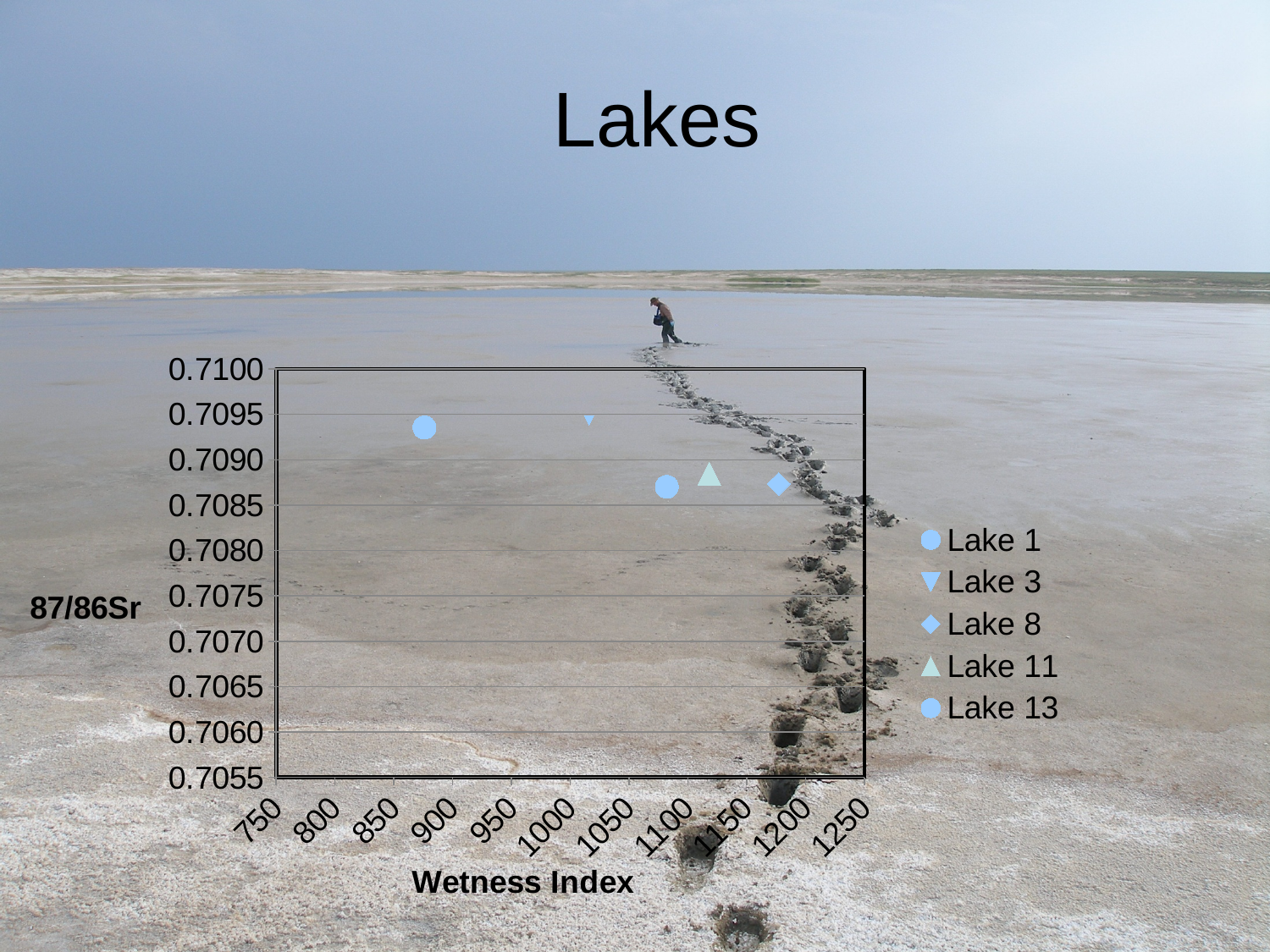
Is the 87/86Sr value for Lake 3 greater or less than 0.7090? greater How many series does the legend list? 5 Which lake has the highest Wetness Index? Lake 8 Which has the higher 87/86Sr value, Lake 3 or Lake 8? Lake 3 What is the label of the x axis? Wetness Index How many data points are plotted on the chart? 5 Is the Wetness Index for Lake 8 greater or less than 1150? greater What kind of chart is shown on the slide? scatter chart What is the label of the y axis? 87/86Sr Is the 87/86Sr value for Lake 11 greater or less than 0.7085? greater